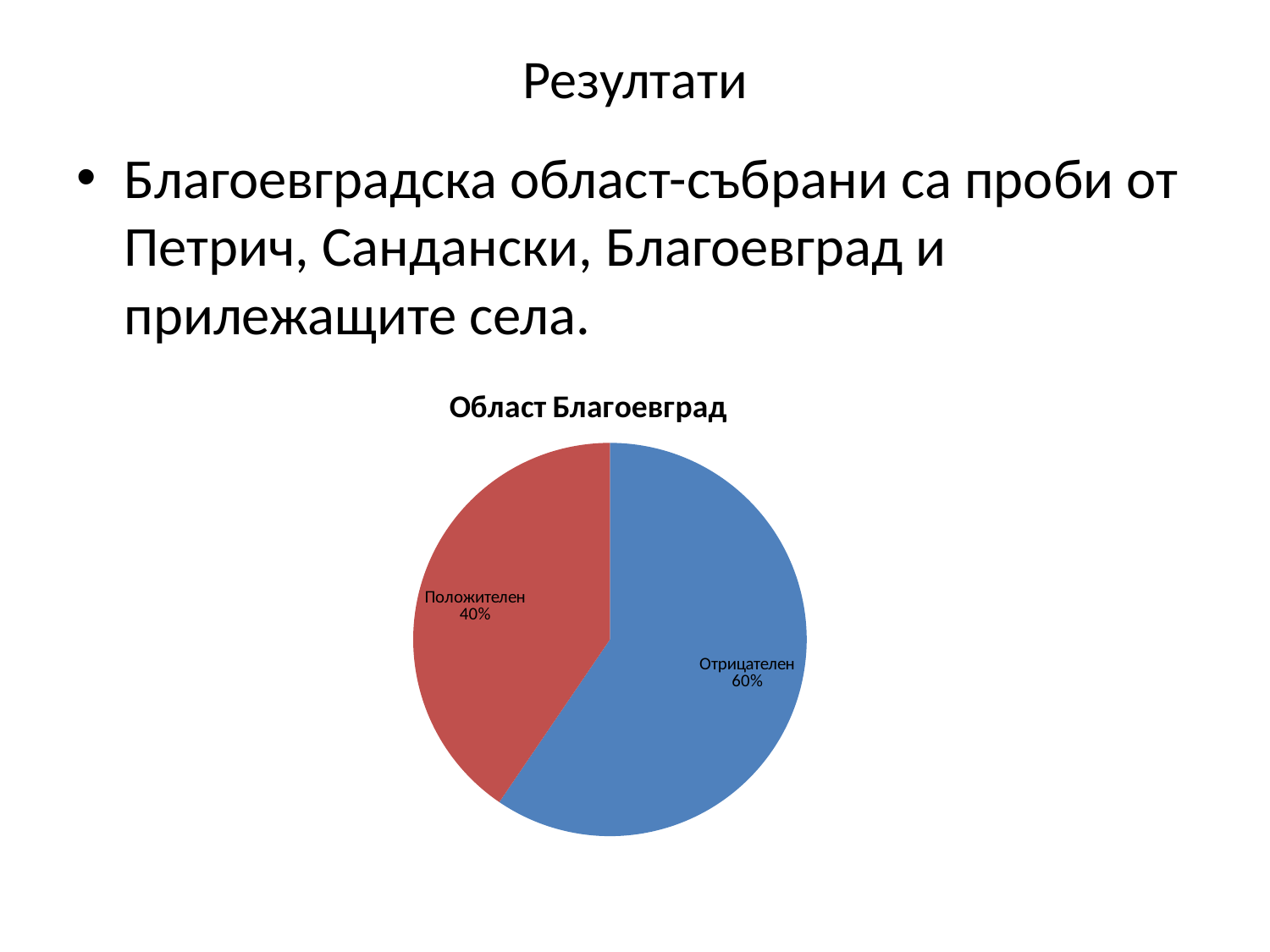
How many slices does the pie chart have? 2 Which is larger, the Положителен slice or the Отрицателен slice? Отрицателен What colour is the Отрицателен slice? blue What kind of chart is shown on the slide? pie chart What is the difference in percentage points between the Отрицателен and Положителен slices? 20% What share of the pie is labelled Отрицателен? 60% What share of the pie is labelled Положителен? 40% Is the share for Положителен greater or less than 50%? less Which slice of the pie is the smallest? Положителен What is the title of the chart? Област Благоевград Which slice of the pie is the largest? Отрицателен